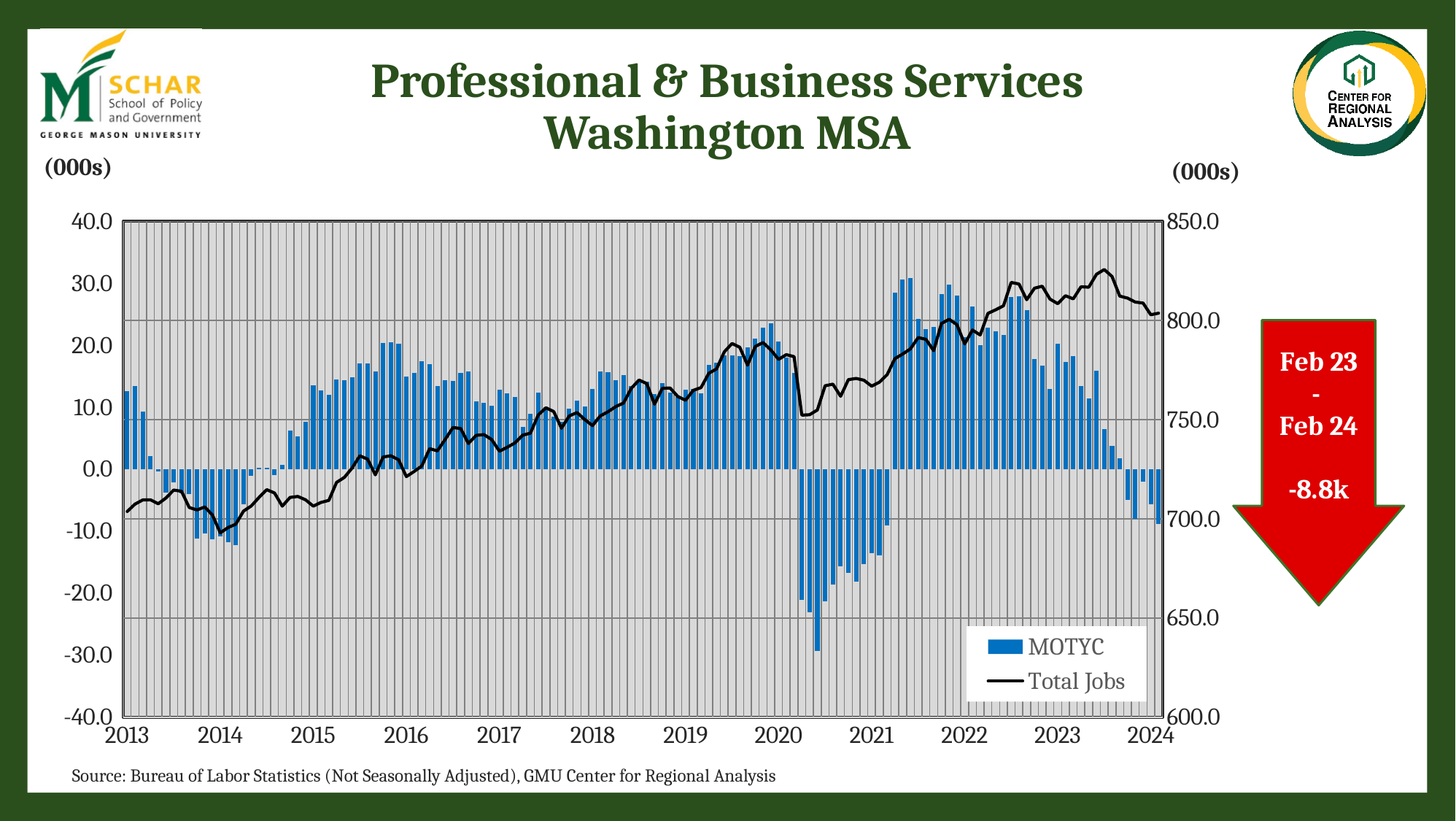
Is the Total Jobs value at the start of 2013 greater or less than 750.0? less What kind of chart is shown on the slide? A combination bar and line chart Is the Total Jobs value at the end of 2024 greater or less than 750.0? greater Is the peak Total Jobs value in 2023 greater or less than 800.0? greater Which is larger: the Total Jobs value at the start of 2013 or at the start of 2022? Start of 2022 How many series does the chart legend list? 2 What are the two series named in the chart legend? MOTYC and Total Jobs In which year does the lowest MOTYC bar occur? 2020 What is the title of the chart? Professional & Business Services Washington MSA According to the annotation on the slide, what was the change in jobs from Feb 23 to Feb 24? -8.8k Overall, does the Total Jobs line rise or fall from 2013 to 2024? rise